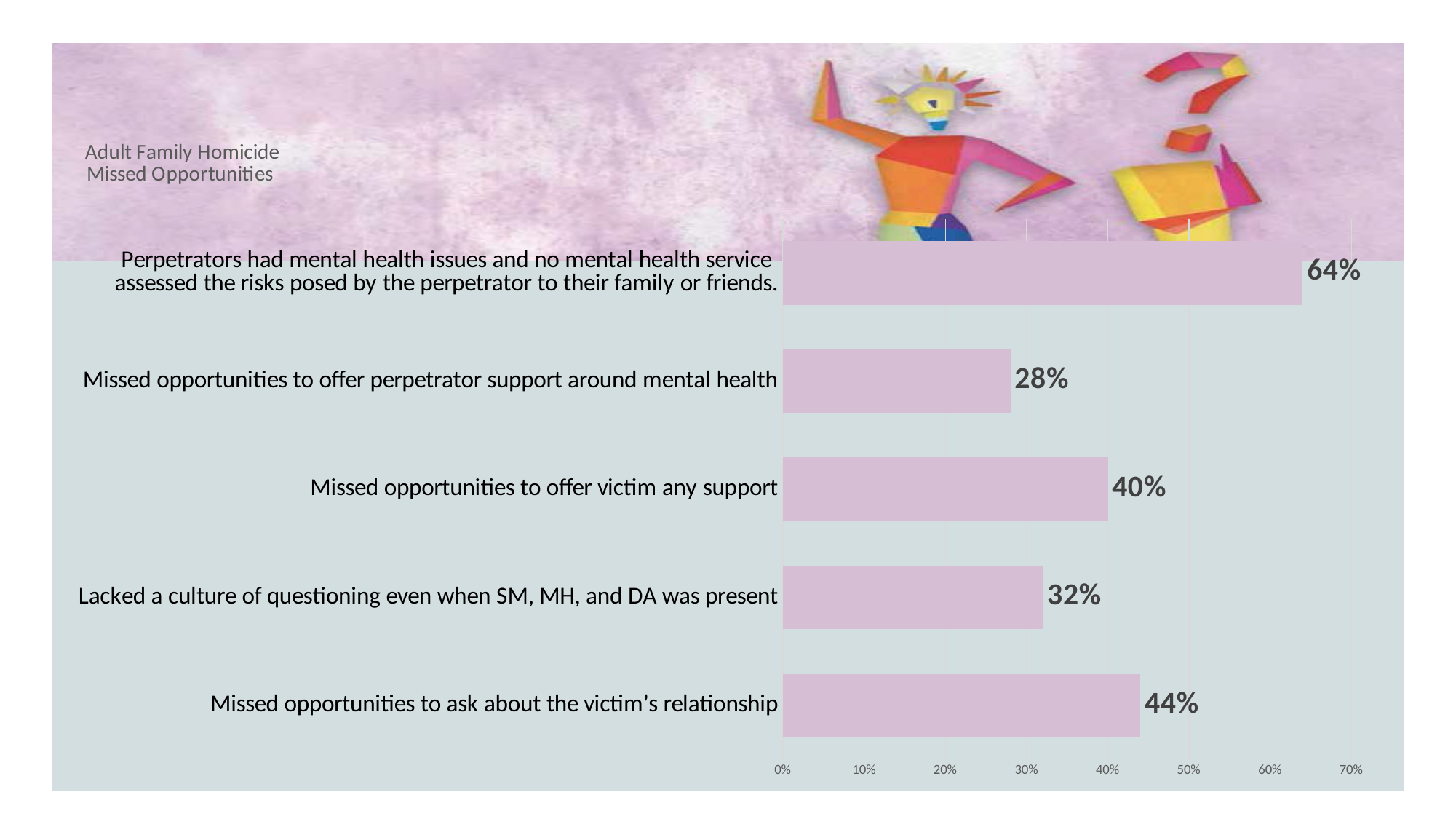
What is the value for 'Missed opportunities to offer victim any support'? 40% What is the difference between the highest value (64%) and the value for 'Missed opportunities to offer perpetrator support around mental health'? 36% What is the difference between 'Missed opportunities to ask about the victim's relationship' and 'Missed opportunities to offer victim any support'? 4% What kind of chart is shown on the slide? Bar chart What is the value for 'Missed opportunities to offer perpetrator support around mental health'? 28% Which category has the highest value? Perpetrators had mental health issues and no mental health service assessed the risks posed by the perpetrator to their family or friends. What is the title shown on the slide for this chart? Adult Family Homicide Missed Opportunities How many categories are shown in the chart? 5 Which category has the lowest value? Missed opportunities to offer perpetrator support around mental health What is the value for 'Lacked a culture of questioning even when SM, MH, and DA was present'? 32% What is the value for 'Missed opportunities to ask about the victim's relationship'? 44% Which is larger: 'Missed opportunities to offer victim any support' or 'Lacked a culture of questioning even when SM, MH, and DA was present'? Missed opportunities to offer victim any support